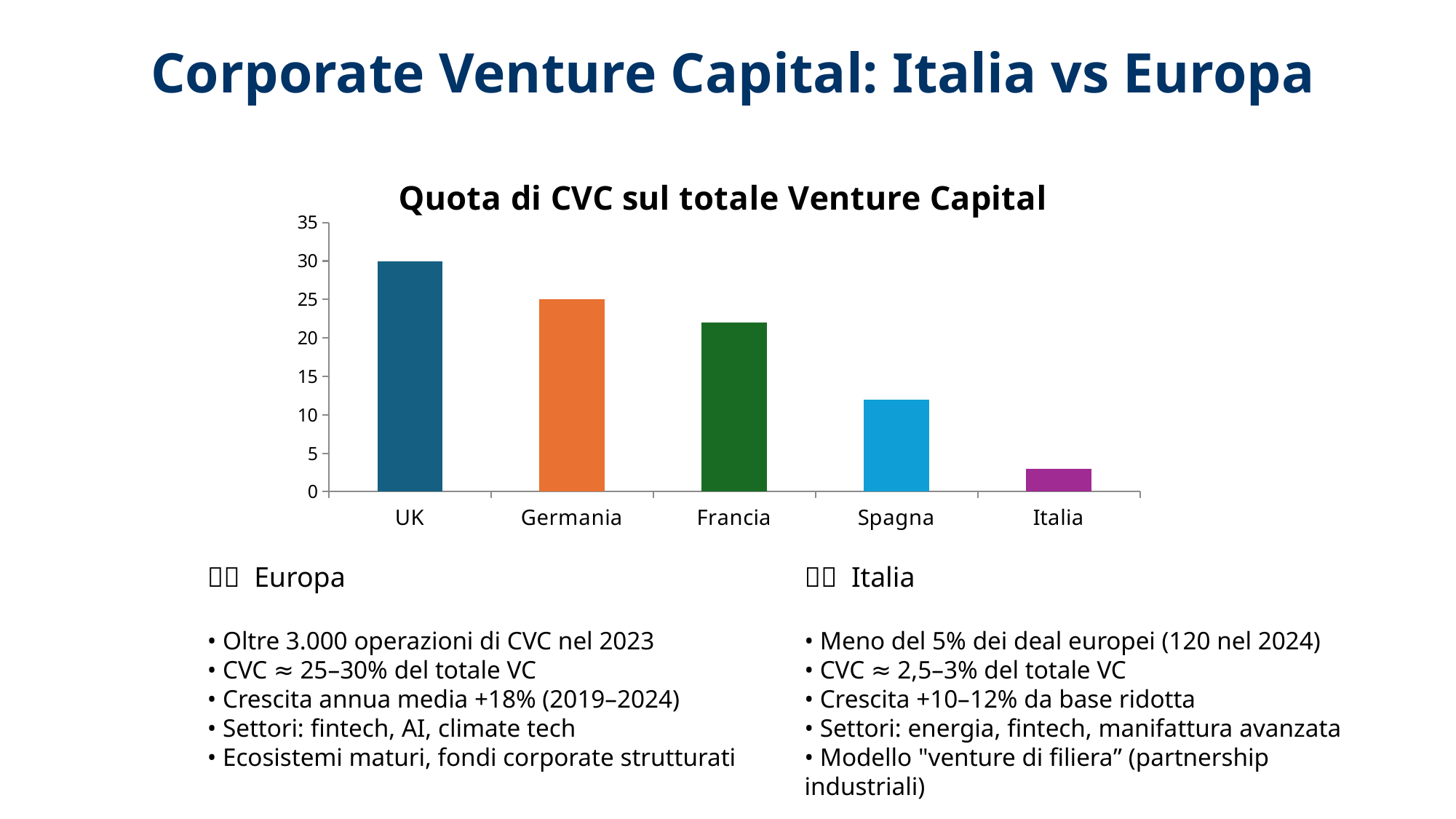
Is the value for Spagna greater or less than 15? less Is the value for Italia greater or less than 5? less What is the value for Germania in the chart? 25 Which country has the highest bar in the chart? UK Do the bar values rise or fall from left to right along the x axis? fall What is the value for UK in the chart? 30 What is the title of the chart? Quota di CVC sul totale Venture Capital How many countries are shown on the x axis of the chart? 5 What kind of chart is shown on the slide? bar chart Which is larger, the value for Francia or the value for Spagna? Francia Is the value for Francia greater or less than 20? greater Which country has the lowest bar in the chart? Italia